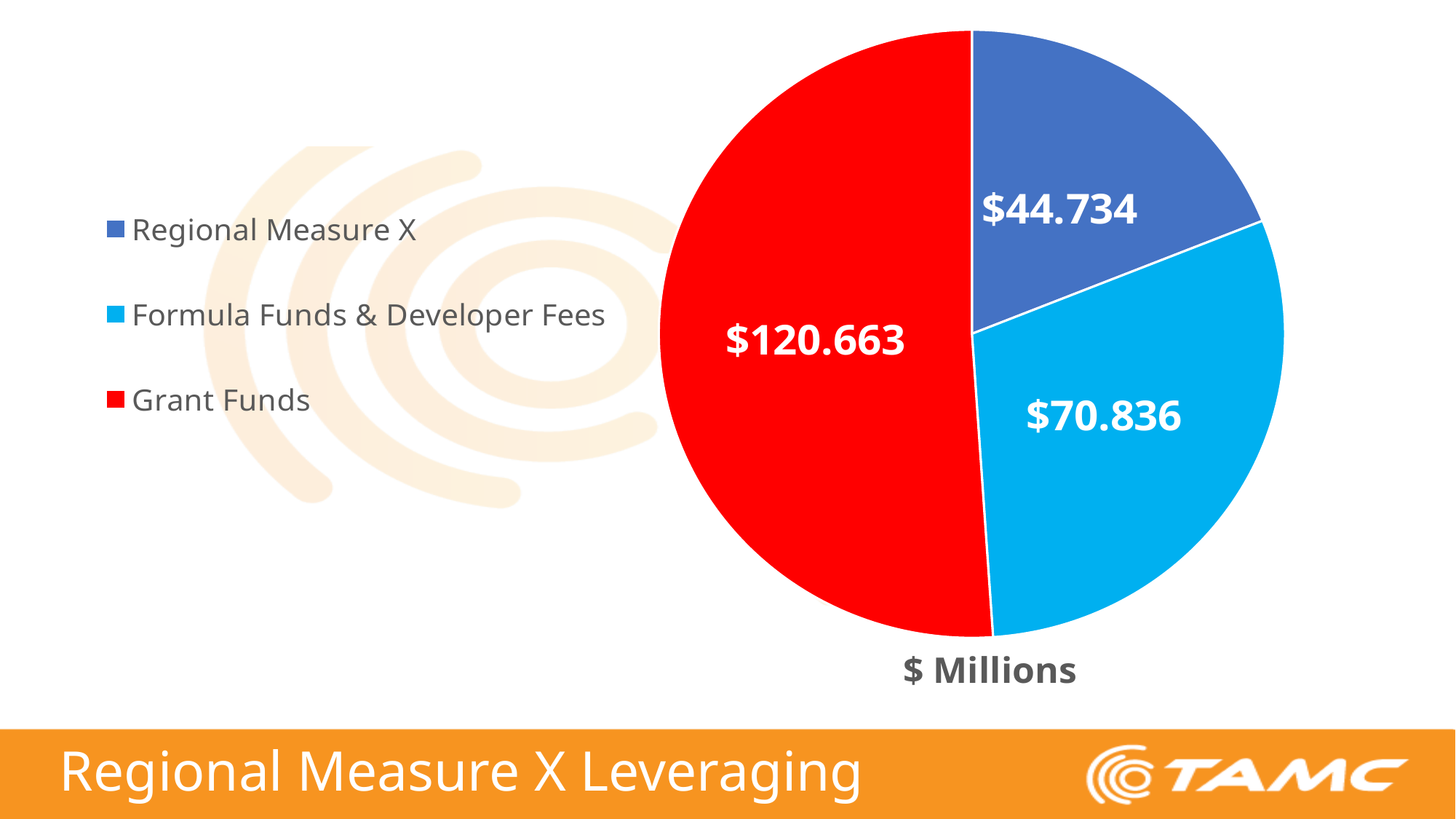
What is the total of all three slices in the pie chart? $236.233 What is the difference between the Grant Funds value and the Formula Funds & Developer Fees value? $49.827 What unit label is shown beneath the pie chart? $ Millions What is the value for Grant Funds in the pie chart? $120.663 Which category has the largest slice of the pie chart? Grant Funds Which is larger, Formula Funds & Developer Fees or Regional Measure X? Formula Funds & Developer Fees What is the value for Formula Funds & Developer Fees in the pie chart? $70.836 Which category has the smallest slice of the pie chart? Regional Measure X What is the value for Regional Measure X in the pie chart? $44.734 What is the difference between the Formula Funds & Developer Fees value and the Regional Measure X value? $26.102 How many slices does the pie chart have? 3 What kind of chart is shown on the slide? Pie chart